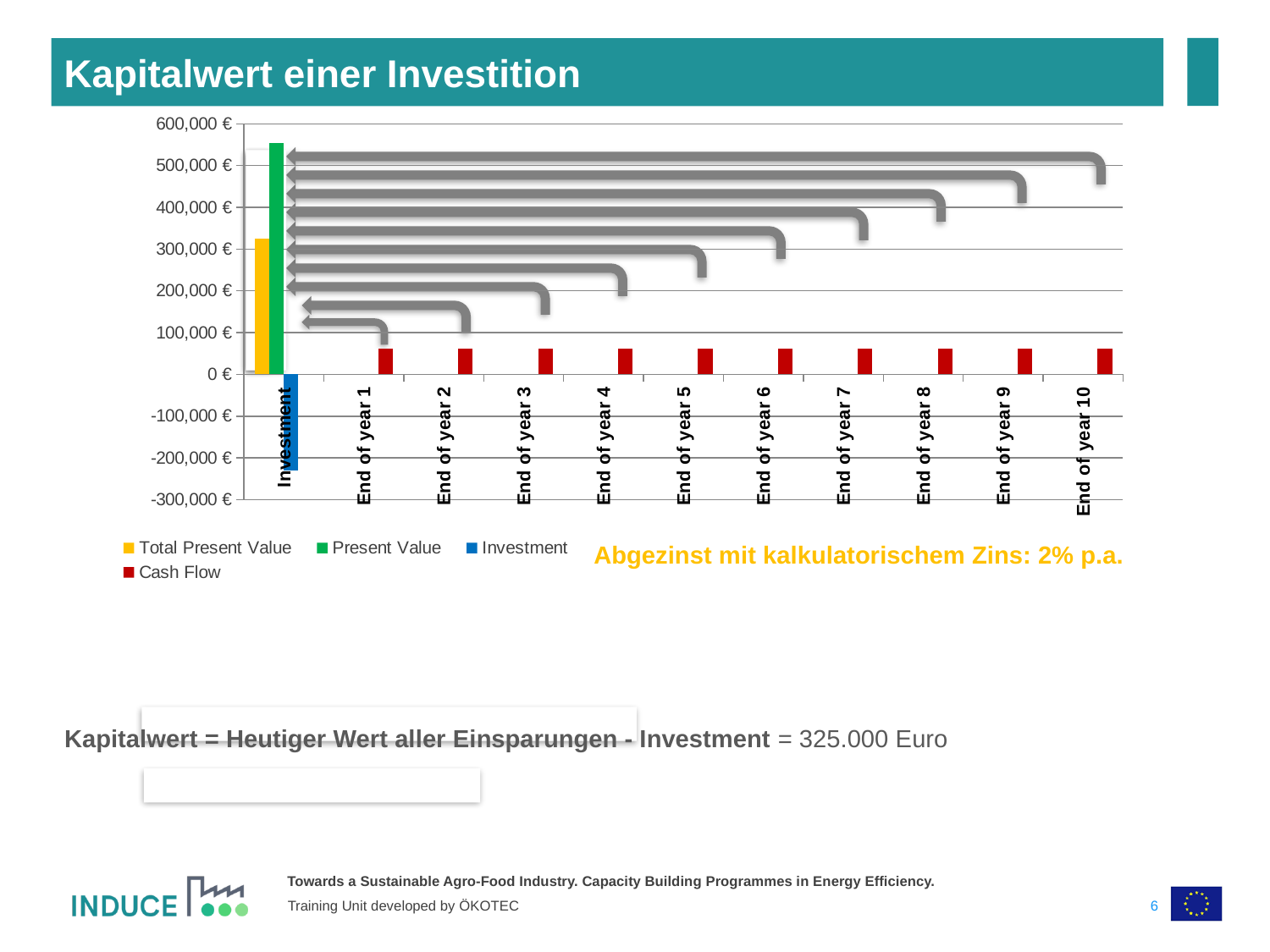
Which series has the lowest (most negative) bar in the chart? Investment Is the Cash Flow bar for End of year 1 greater or less than 100,000 €? less How many categories are shown along the x axis of the chart? 11 Which series has the tallest bar in the chart? Present Value What kind of chart is shown on the slide? bar chart How many series does the chart legend list? 4 Do the Cash Flow bars rise, fall, or stay roughly the same from End of year 1 to End of year 10? stay roughly the same Which is larger, the Present Value bar or the Total Present Value bar? Present Value Is the Present Value bar greater or less than 500,000 €? greater Is the Investment bar greater or less than -200,000 €? less What colour represents the Cash Flow series in the chart legend? red